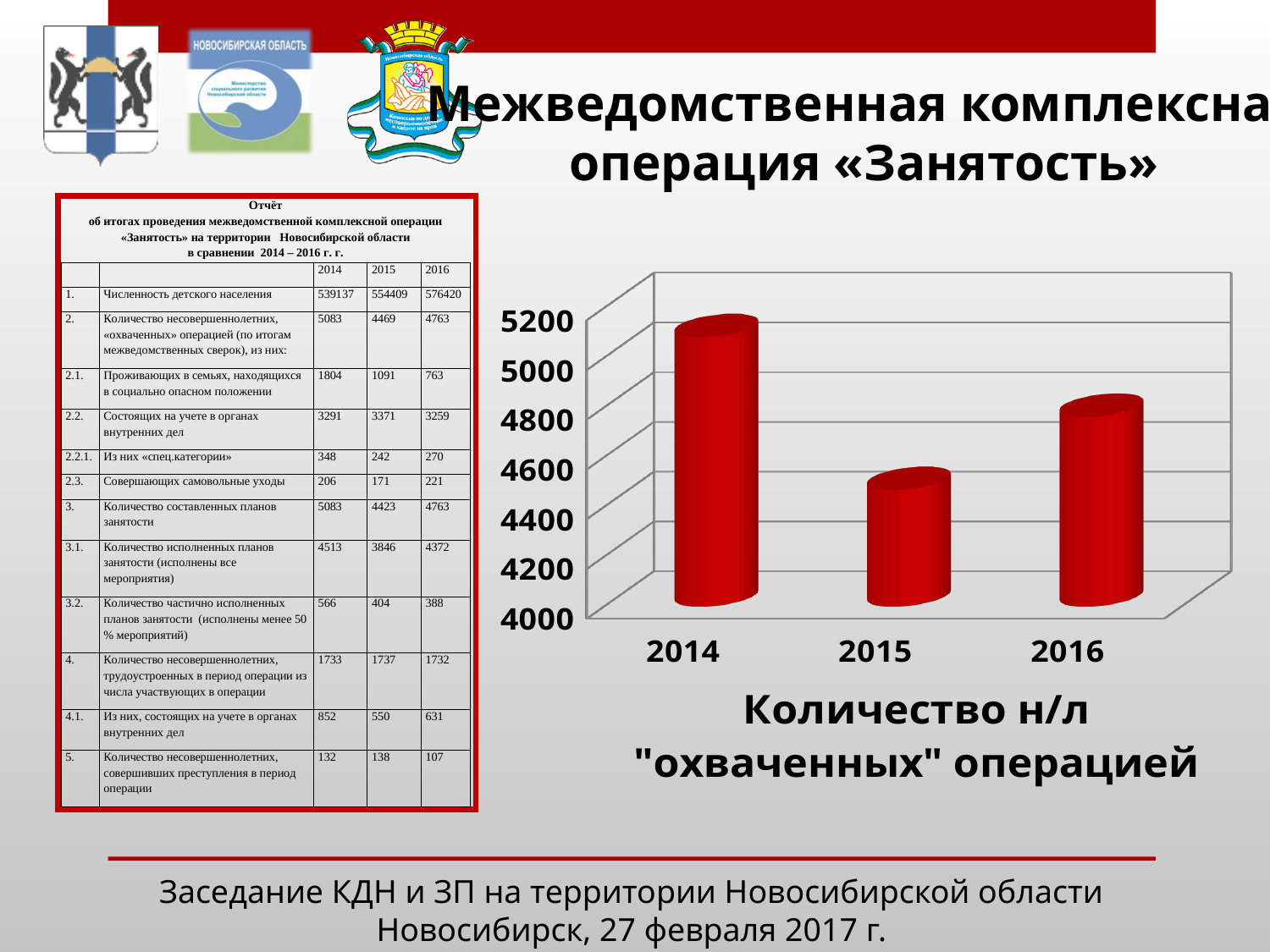
What kind of chart is shown on the slide? bar chart Is the value for 2016 greater or less than 4600? greater Is the value for 2015 greater or less than 4600? less Which year has the lowest bar in the chart? 2015 What is the title of the chart? Количество н/л "охваченных" операцией What is the lowest value shown on the chart's vertical axis? 4000 Does the value rise or fall from 2014 to 2015? fall Is the value for 2014 greater or less than 5000? greater Which is larger, the value for 2016 or the value for 2015? 2016 How many years (categories) are plotted in the chart? 3 Which year has the highest bar in the chart? 2014